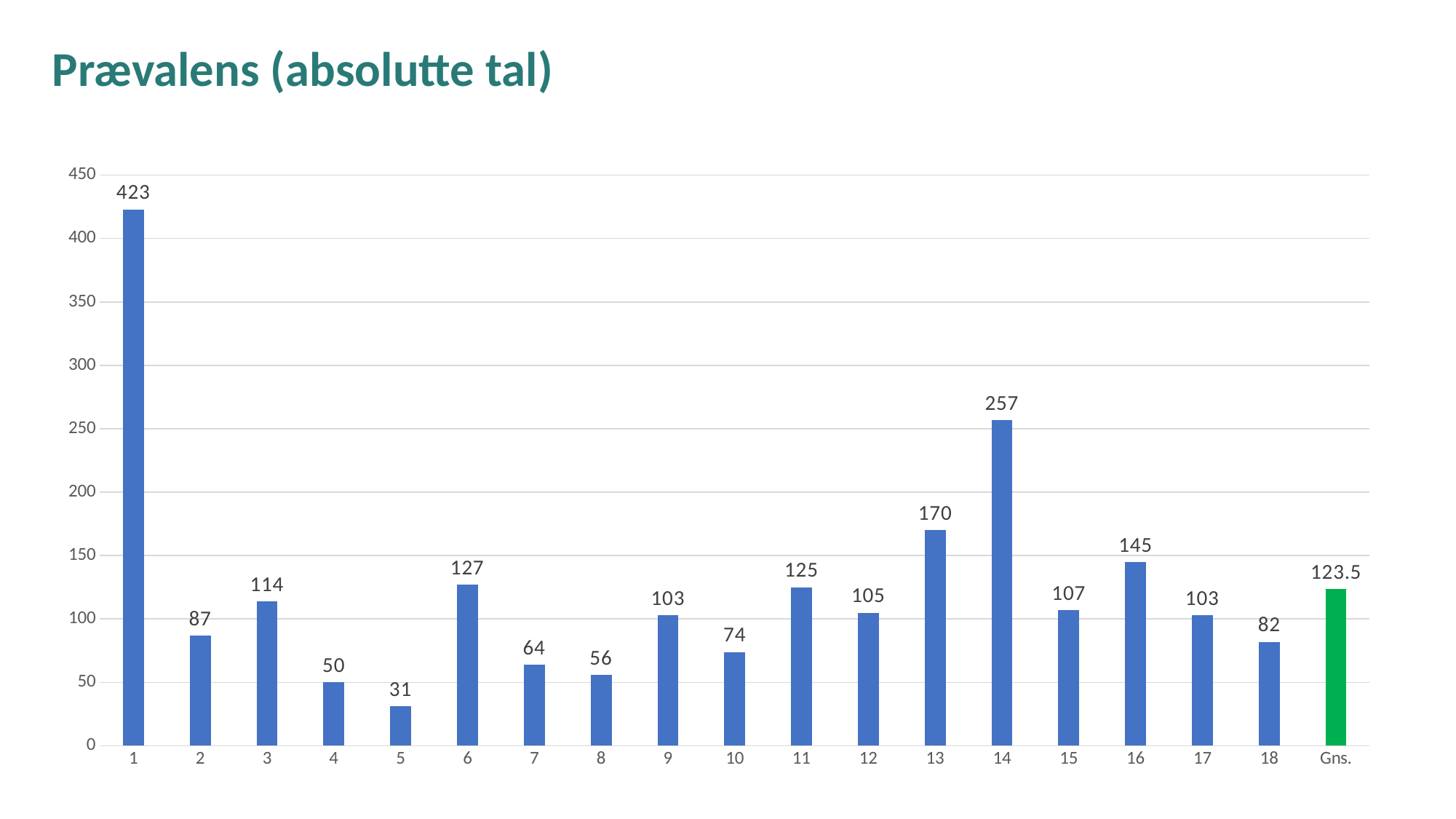
What kind of chart is shown on the slide? bar chart Is the value for category 13 greater or less than 150? greater Which category has the lowest value? 5 What is the title of the chart? Prævalens (absolutte tal) What is the difference between the values for category 1 and category 14? 166 What is the value for category 14? 257 What is the value shown for Gns.? 123.5 What is the difference between the values for category 13 and category 16? 25 How many bars are plotted in the chart? 19 Which is larger, the value for category 6 or the value for category 11? category 6 What is the value for category 1? 423 Which category has the highest value? 1